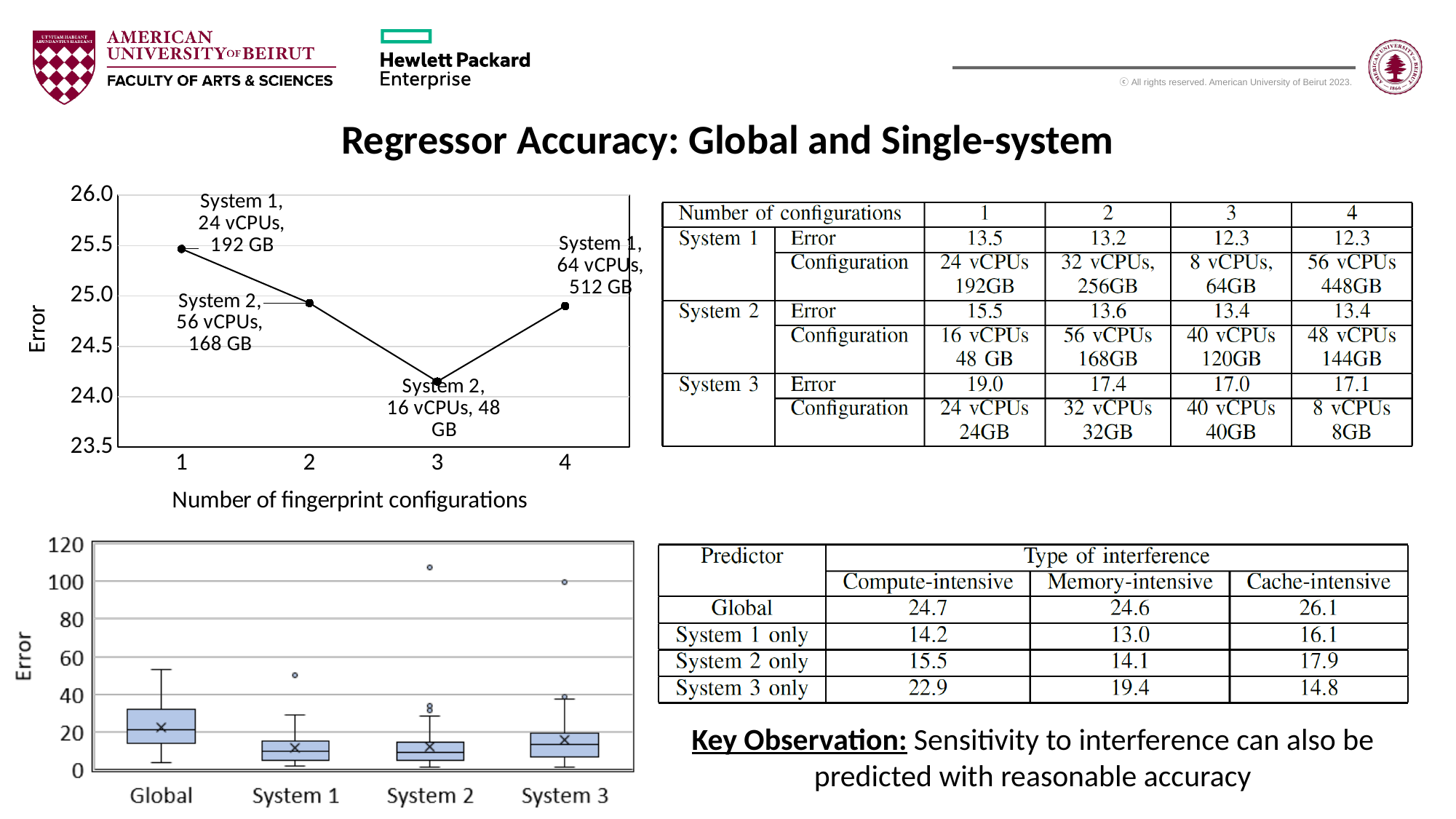
In the top-left line chart, how many data points are plotted? 4 In the top-left line chart, at which number of fingerprint configurations is the error highest? 1 In the top-left line chart, what is the title of the x axis? Number of fingerprint configurations In the bottom-left box plot, which category has the highest median error? Global In the top-left line chart, at which number of fingerprint configurations is the error lowest? 3 What kind of chart is the bottom-left chart with categories Global, System 1, System 2 and System 3? box plot In the bottom-left box plot, how many categories are shown on the x axis? 4 In the top-left line chart, is the error at 3 fingerprint configurations greater or less than 24.5? less In the top-left line chart, does the error rise or fall as the number of fingerprint configurations goes from 1 to 3? fall What kind of chart is the top-left chart with the x axis 'Number of fingerprint configurations'? line chart In the top-left line chart, is the error at 1 fingerprint configuration greater or less than 25.0? greater In the top-left line chart, which configuration label is attached to the point at 3 fingerprint configurations? System 2, 16 vCPUs, 48 GB